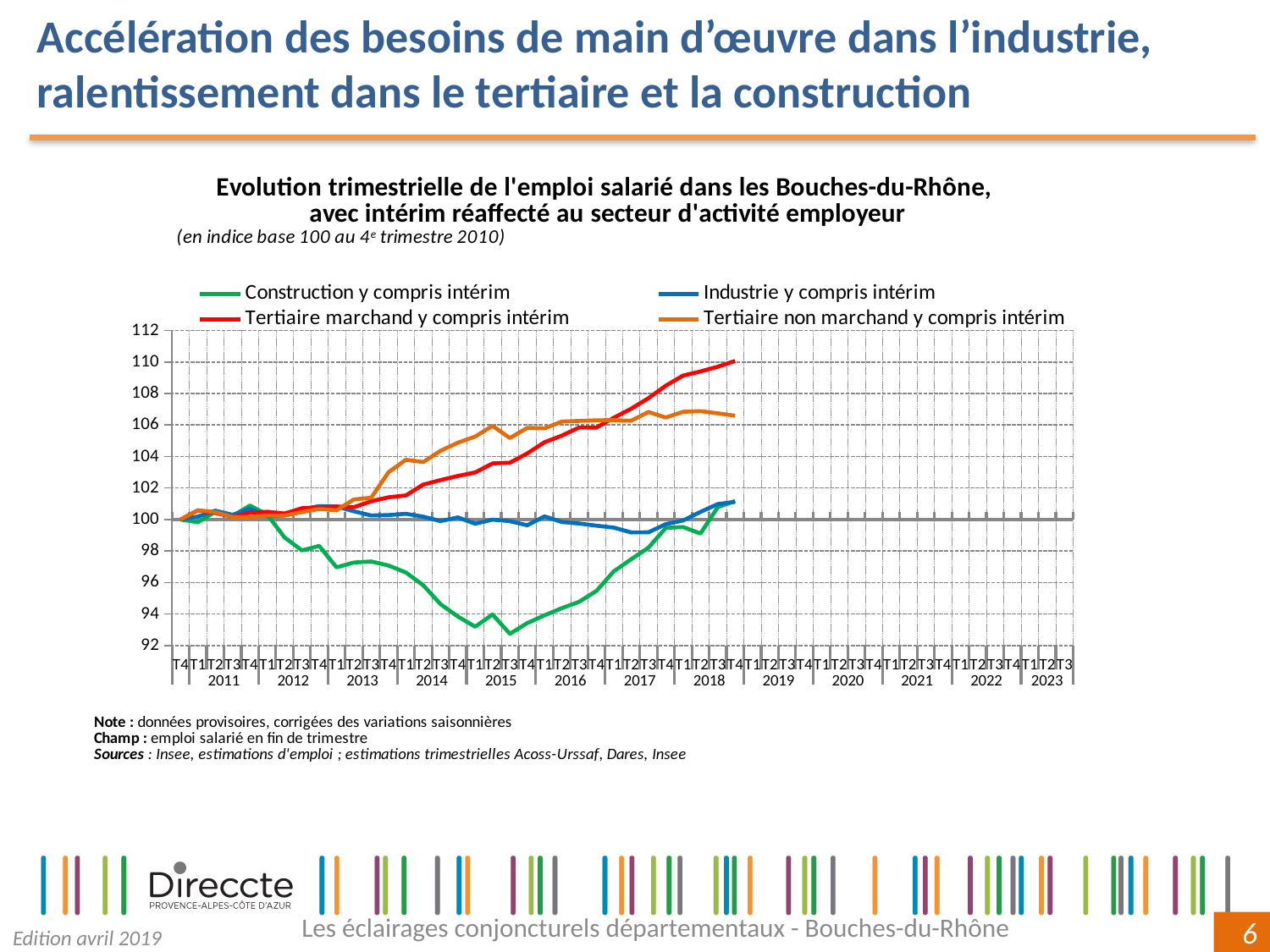
Is the lowest value for Construction y compris intérim (in 2015) greater or less than 94? less What colour is the line for Construction y compris intérim? green How many series does the legend list? 4 Is the value for Tertiaire marchand y compris intérim at the end of 2018 greater or less than 108? greater What is the base of the index used in the chart? base 100 au 4e trimestre 2010 Which series falls to the lowest value on the chart? Construction y compris intérim What kind of chart is shown on the slide? line chart At the end of 2018, which is higher: Tertiaire marchand y compris intérim or Construction y compris intérim? Tertiaire marchand y compris intérim Which series reaches the highest value on the chart? Tertiaire marchand y compris intérim Is the value for Construction y compris intérim at T4 2014 greater or less than 96? less Does the Tertiaire marchand y compris intérim series rise or fall from 2011 to 2018? rise